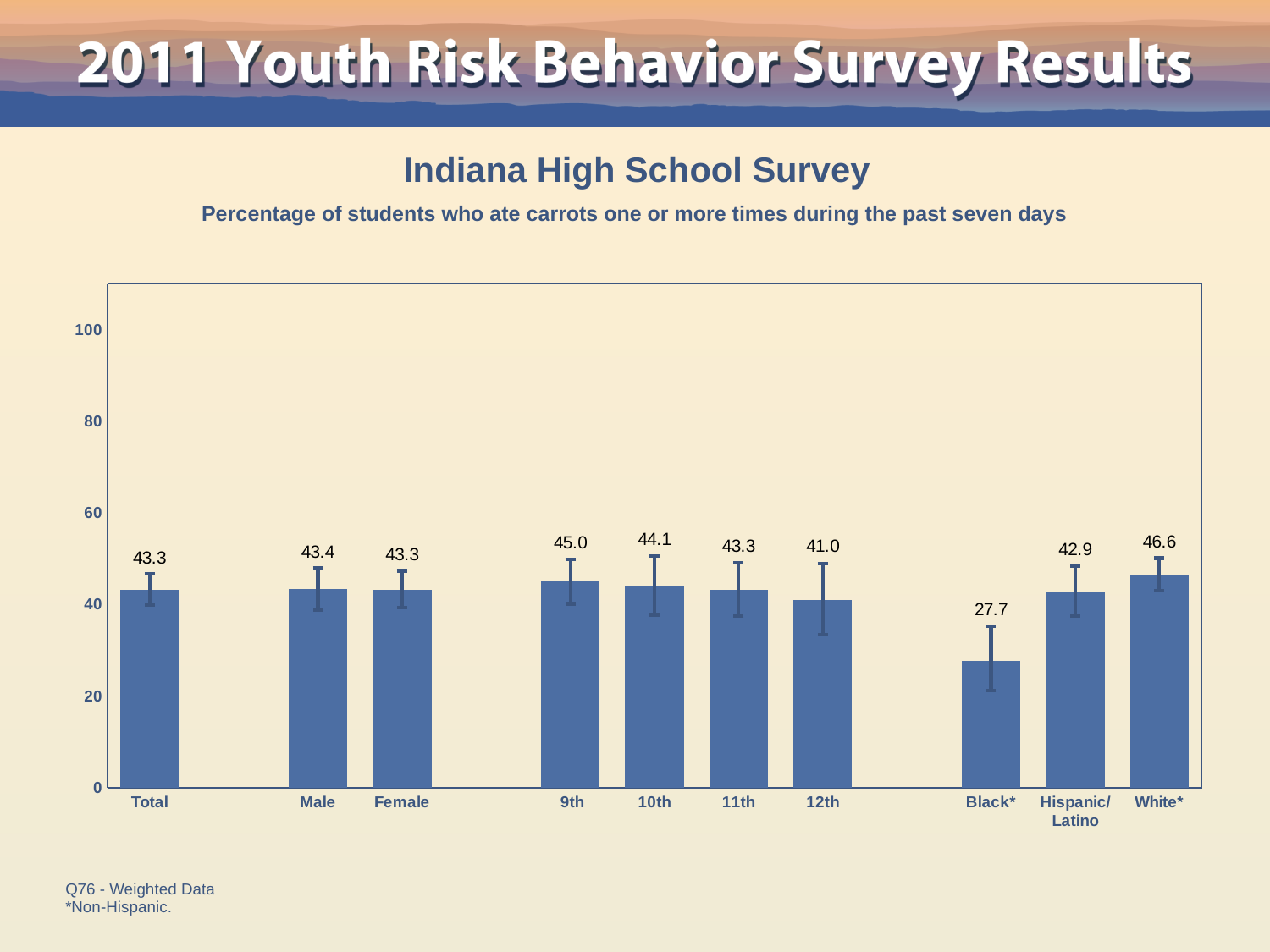
Do the values rise or fall from 9th to 12th grade? fall What is the difference between the values for 9th and 12th? 4.0 Which category has the lowest value? Black* Which is larger, the value for 9th or the value for 12th? 9th What is the value for Total? 43.3 Which category has the highest value? White* What is the difference between the values for White* and Black*? 18.9 How many categories are shown on the x axis? 10 Is the value for Hispanic/Latino greater or less than 60? less What is the value for 12th? 41.0 What kind of chart is this? bar chart What is the value for Black*? 27.7